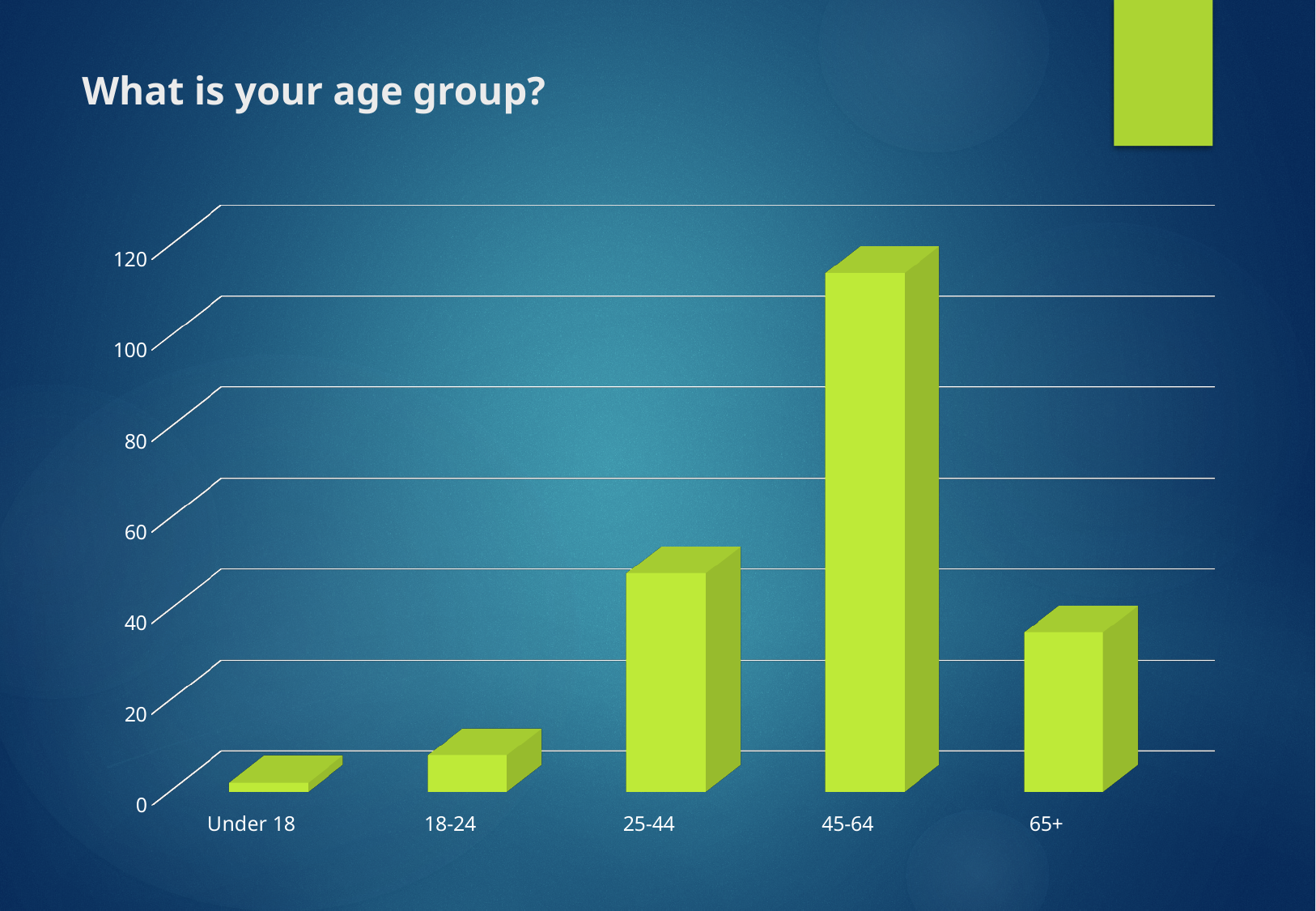
What is the highest value labelled on the vertical axis? 120 How many age group categories are shown on the x axis? 5 Is the value for 25-44 greater or less than 60? less What is the title of the chart? What is your age group? Which has the larger value, 18-24 or 65+? 65+ Is the value for 65+ greater or less than 20? greater What kind of chart is shown on the slide? bar chart Which has the larger value, 25-44 or 65+? 25-44 Is the value for 45-64 greater or less than 100? greater Which age group has the lowest value? Under 18 Which age group has the highest value? 45-64